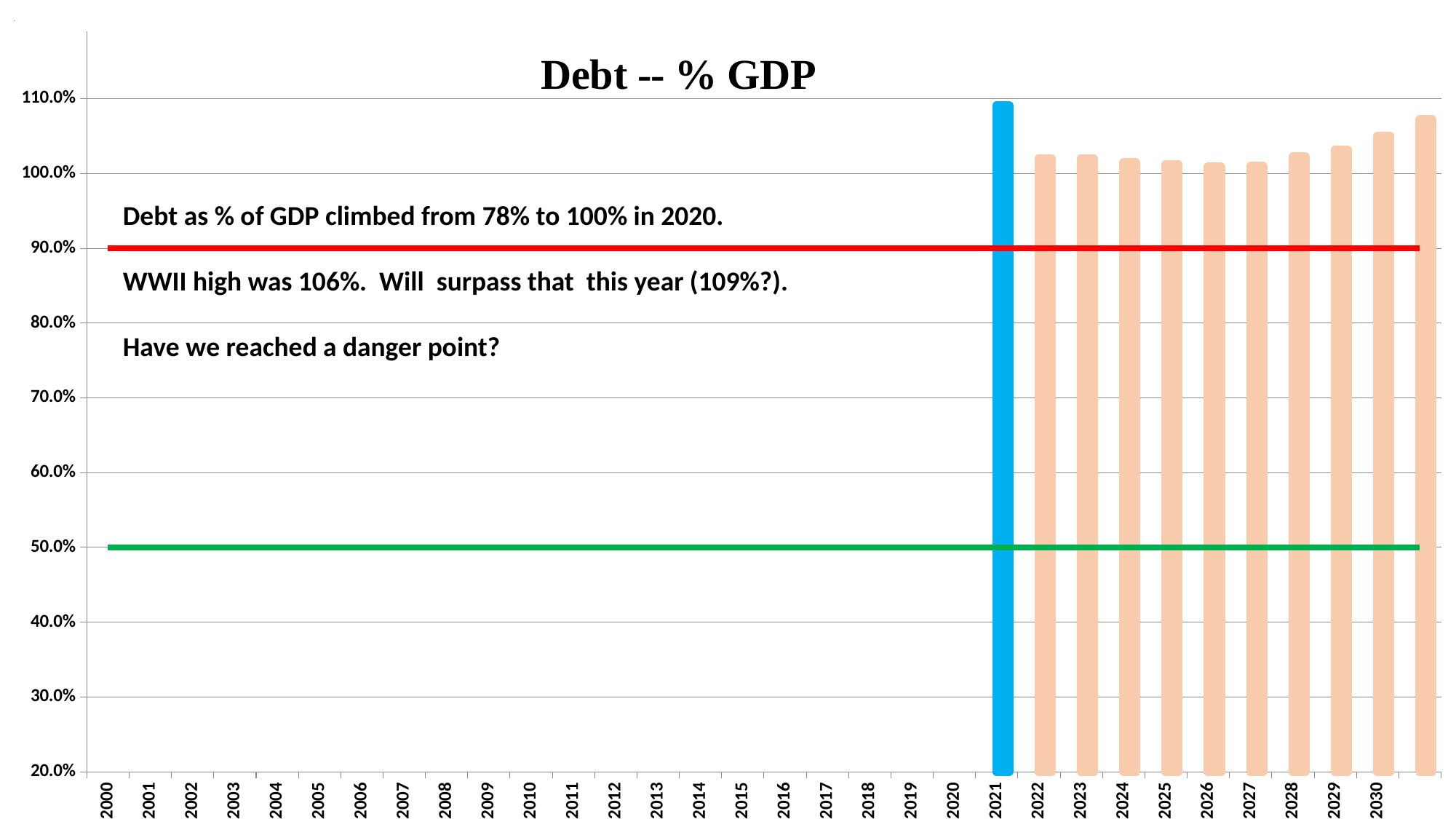
What kind of chart is shown on the slide? combination bar and line chart Is the value for 2030 greater or less than 100%? greater Is the value for 2022 greater or less than 90%? greater Which is larger, the bar for 2021 or the bar for 2022? 2021 Is the value for 2021 greater or less than 100%? greater What is the title of the chart? Debt -- % GDP Which year has the tallest bar in the chart? 2021 What is the last year labelled on the x axis? 2030 Do the bars rise or fall from 2026 to 2030? rise At what level on the y axis is the red horizontal line drawn? 90.0% What is the highest value labelled on the y axis? 110.0% What is the first year shown on the x axis? 2000